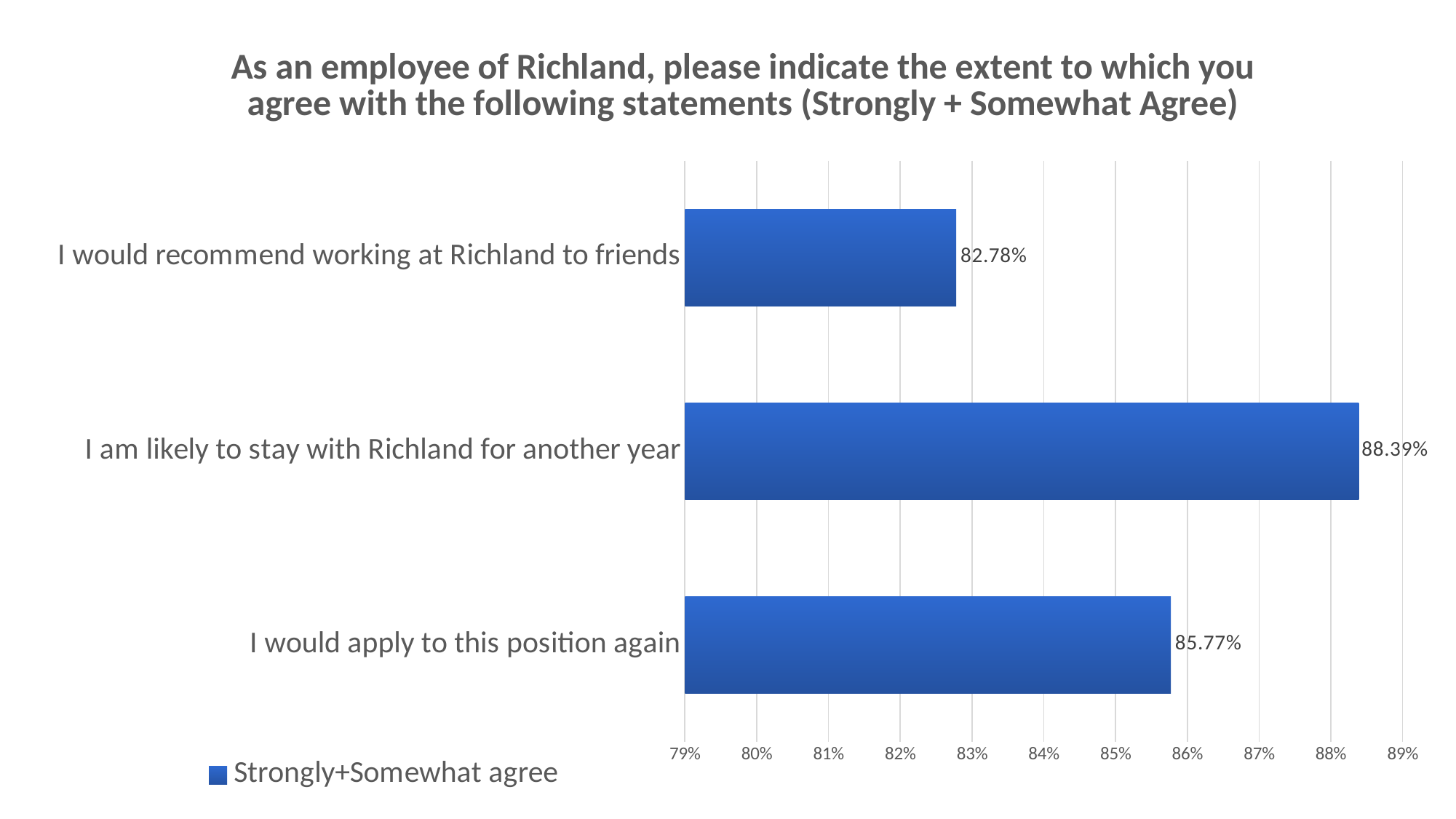
Which is larger: the value for "I would apply to this position again" or the value for "I would recommend working at Richland to friends"? I would apply to this position again What is the difference between the values for "I am likely to stay with Richland for another year" and "I would recommend working at Richland to friends"? 5.61% What kind of chart is shown on the slide? Bar chart Which statement has the highest agreement percentage? I am likely to stay with Richland for another year How many series does the legend list? 1 What is the value for "I would recommend working at Richland to friends"? 82.78% Which statement has the lowest agreement percentage? I would recommend working at Richland to friends What is the value for "I am likely to stay with Richland for another year"? 88.39% What is the difference between the values for "I would apply to this position again" and "I would recommend working at Richland to friends"? 2.99% Is the value for "I would apply to this position again" greater or less than 85%? greater How many statements are shown in the chart? 3 What is the value for "I would apply to this position again"? 85.77%